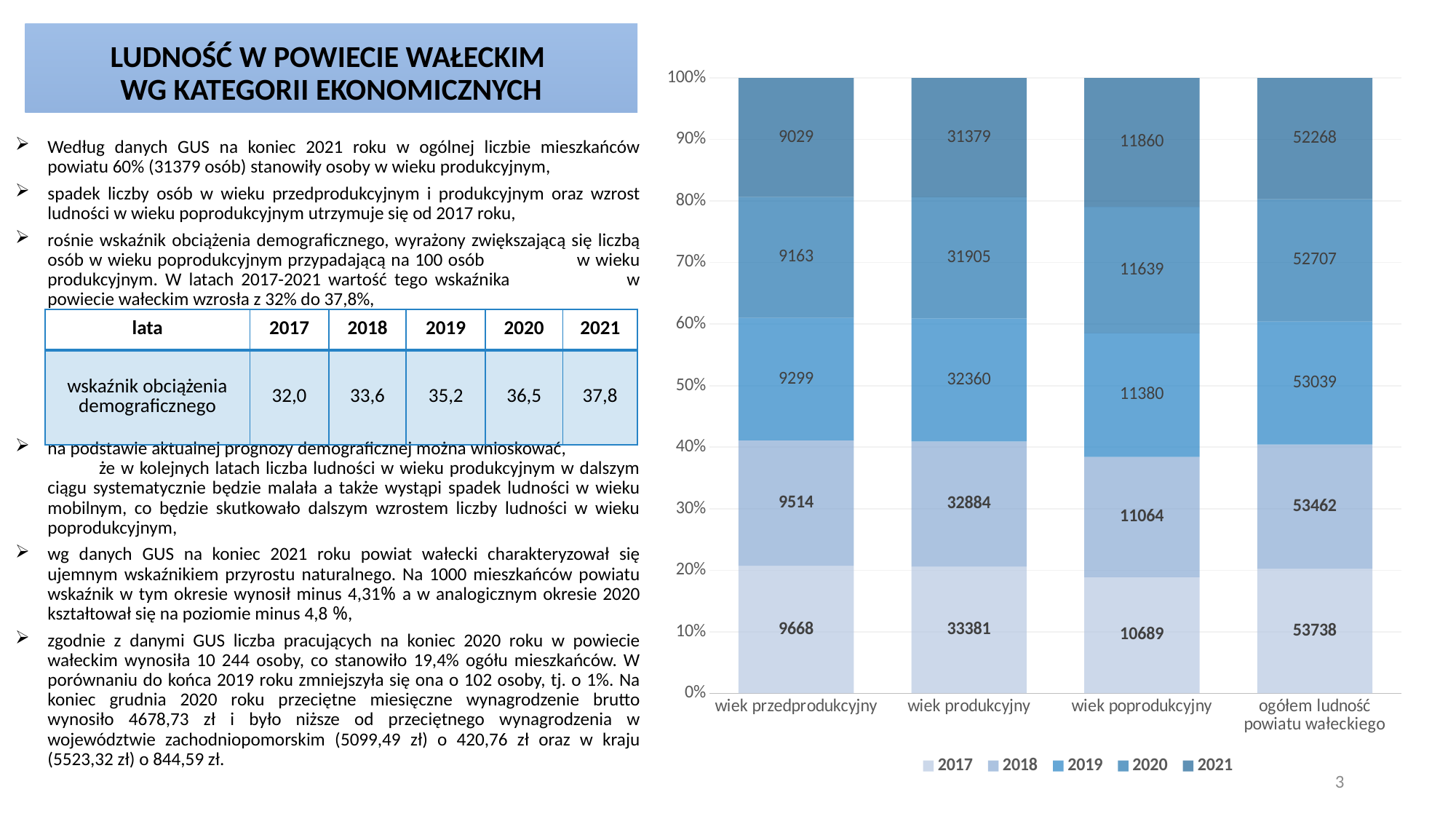
How many series does the chart legend list? 5 What is the value for 2021 in the 'wiek produkcyjny' category? 31379 What is the difference between the 2017 and 2021 values in the 'ogółem ludność powiatu wałeckiego' category? 1470 Which year has the highest value in the 'wiek poprodukcyjny' category? 2021 Which is larger in the 'wiek przedprodukcyjny' category: the value for 2018 or the value for 2020? 2018 What is the value for 2020 in the 'wiek poprodukcyjny' category? 11639 Do the values in the 'wiek poprodukcyjny' category rise or fall from 2017 to 2021? rise What is the value for 2019 in the 'ogółem ludność powiatu wałeckiego' category? 53039 Which year has the lowest value in the 'wiek produkcyjny' category? 2021 How many categories are shown on the x axis of the chart? 4 What kind of chart is shown on the slide? 100% stacked bar chart What is the value for 2017 in the 'wiek przedprodukcyjny' category? 9668